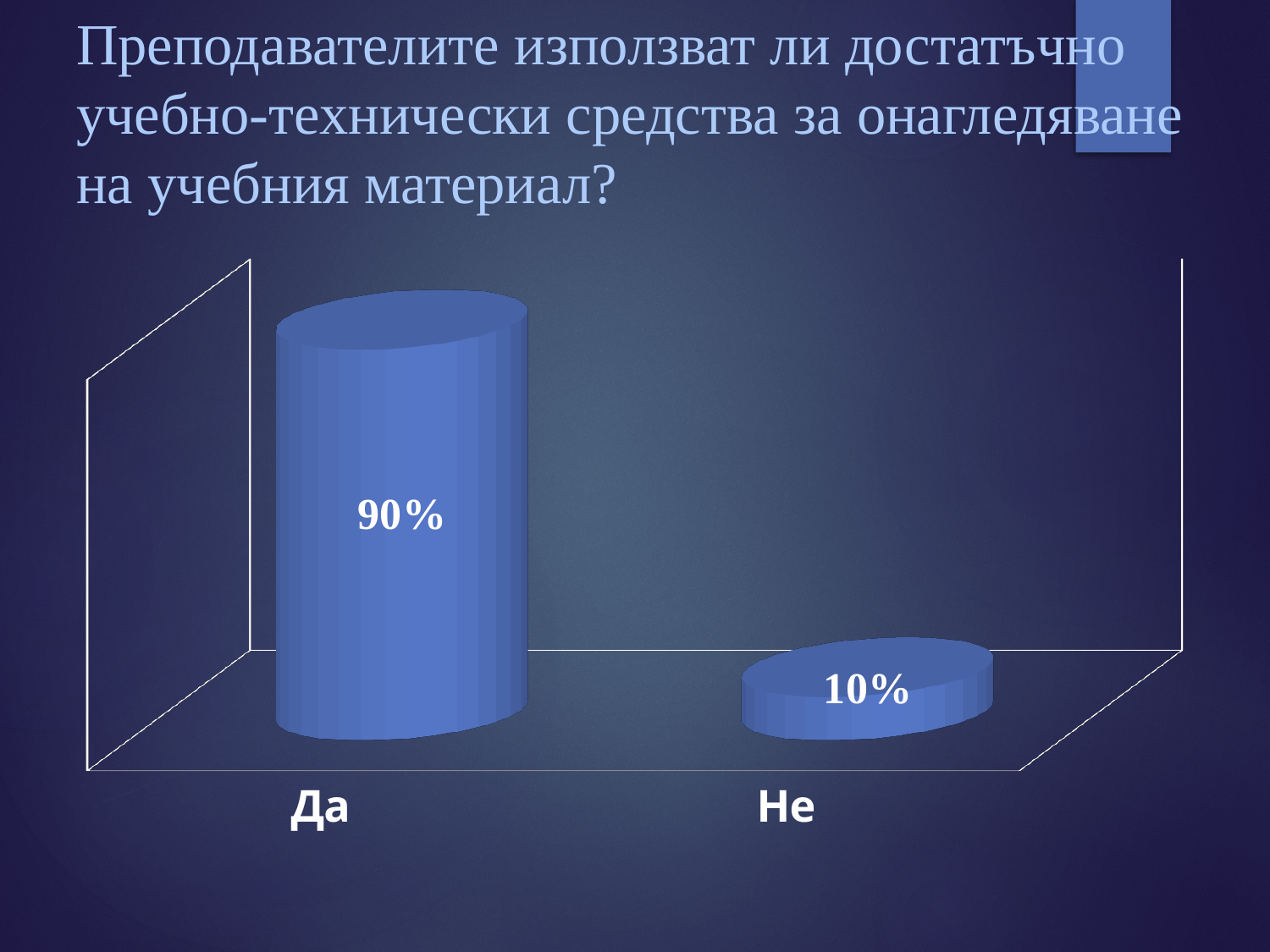
Which category has the lowest value? Не What is the difference between the values for "Да" and "Не"? 80% Which is larger, the value for "Да" or the value for "Не"? Да What is the value for "Не"? 10% What colour are the bars in the chart? Blue What is the value for "Да"? 90% How many categories are shown in the chart? 2 What are the category labels on the x axis? Да, Не Which category has the highest value? Да What kind of chart is shown on the slide? Bar chart What is the total of the two values shown in the chart? 100%